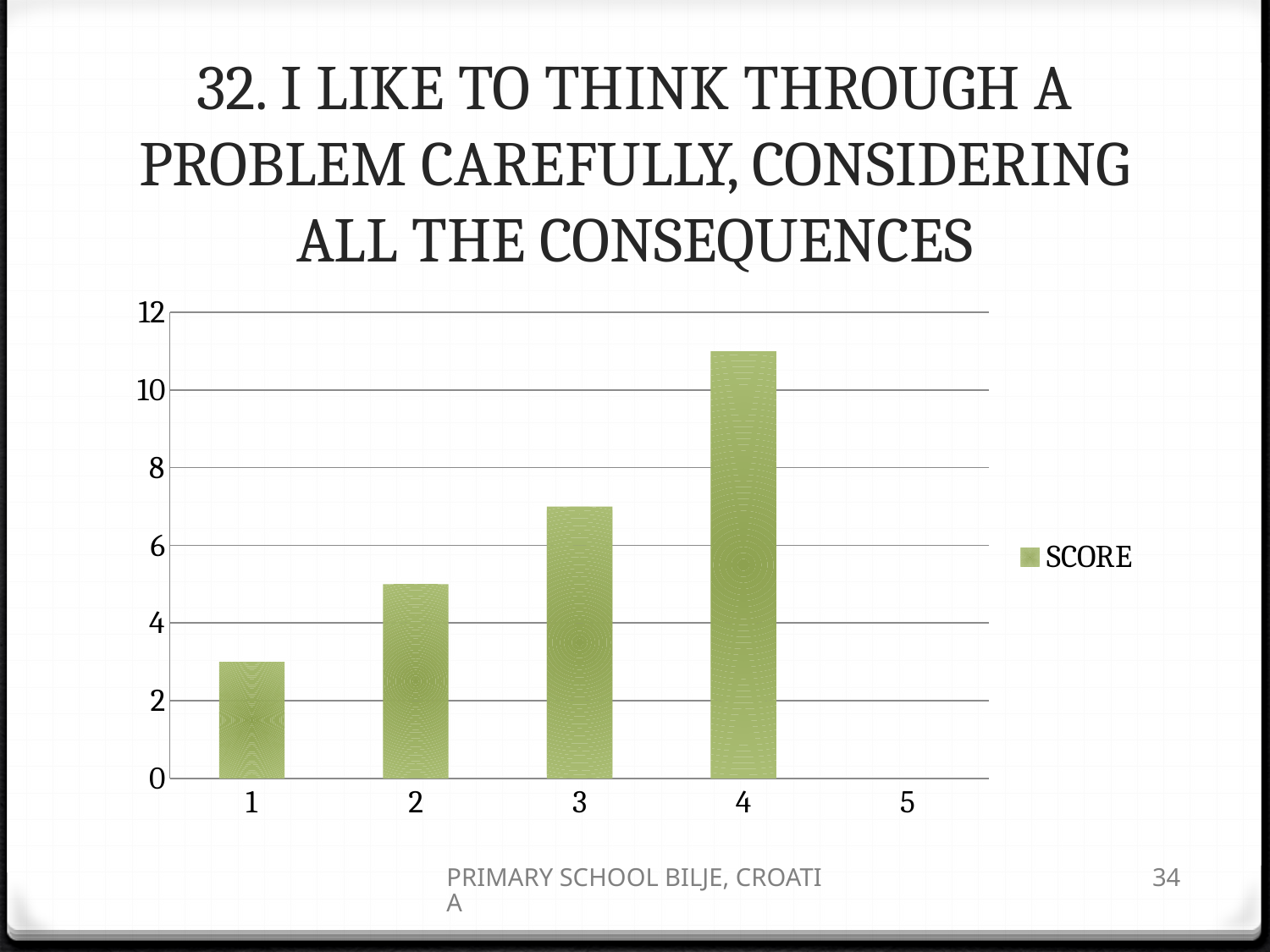
Which category has the tallest bar? 4 Which category has the lowest value? 5 How many series does the chart legend list? 1 Is the value for category 1 greater or less than 4? less What kind of chart is shown on the slide? bar chart Is the value for category 3 greater or less than 6? greater Is the value for category 4 greater or less than 10? greater Which has the larger value, category 1 or category 4? 4 Which has the larger value, category 2 or category 3? 3 Do the values rise or fall from category 1 to category 4? rise What is the name of the series shown in the legend? SCORE How many categories are shown on the x axis of the chart? 5